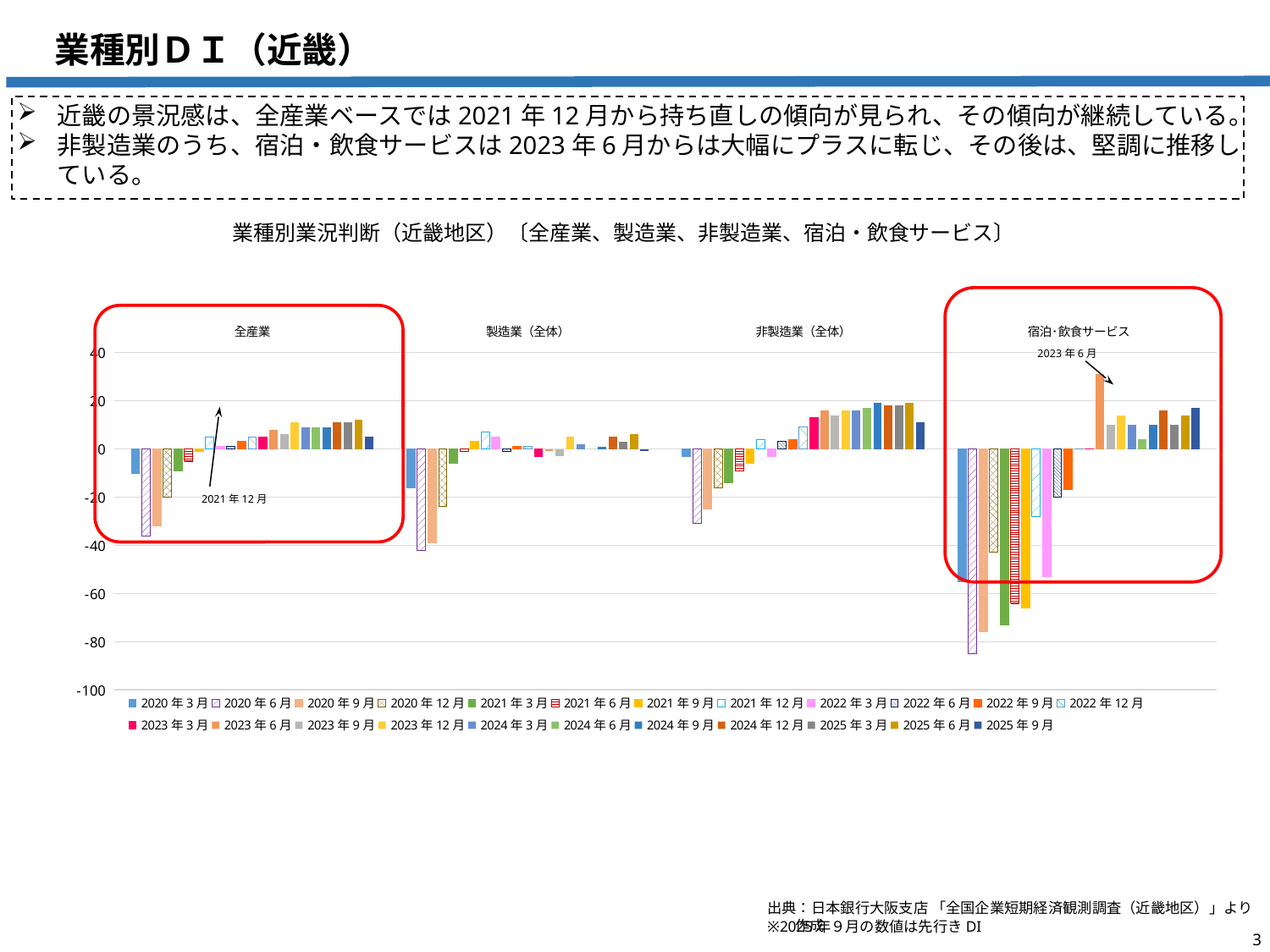
Is the value for 2020年6月 in the 製造業（全体） group greater or less than -20? less What kind of chart is shown on the slide? bar chart For 2020年6月, which group has the lower value: 製造業（全体） or 非製造業（全体）? 製造業（全体） What is the lowest tick value shown on the chart's vertical axis? -100 Is the value for 2023年6月 in the 宿泊・飲食サービス group greater or less than 20? greater Is the value for 2020年6月 in the 宿泊・飲食サービス group greater or less than -80? less Which industry group contains the lowest bar in the chart? 宿泊・飲食サービス How many series does the chart's legend list? 23 In the 全産業 group, do the values rise or fall from 2020年9月 to 2021年12月? rise How many industry groups are plotted along the x axis of the chart? 4